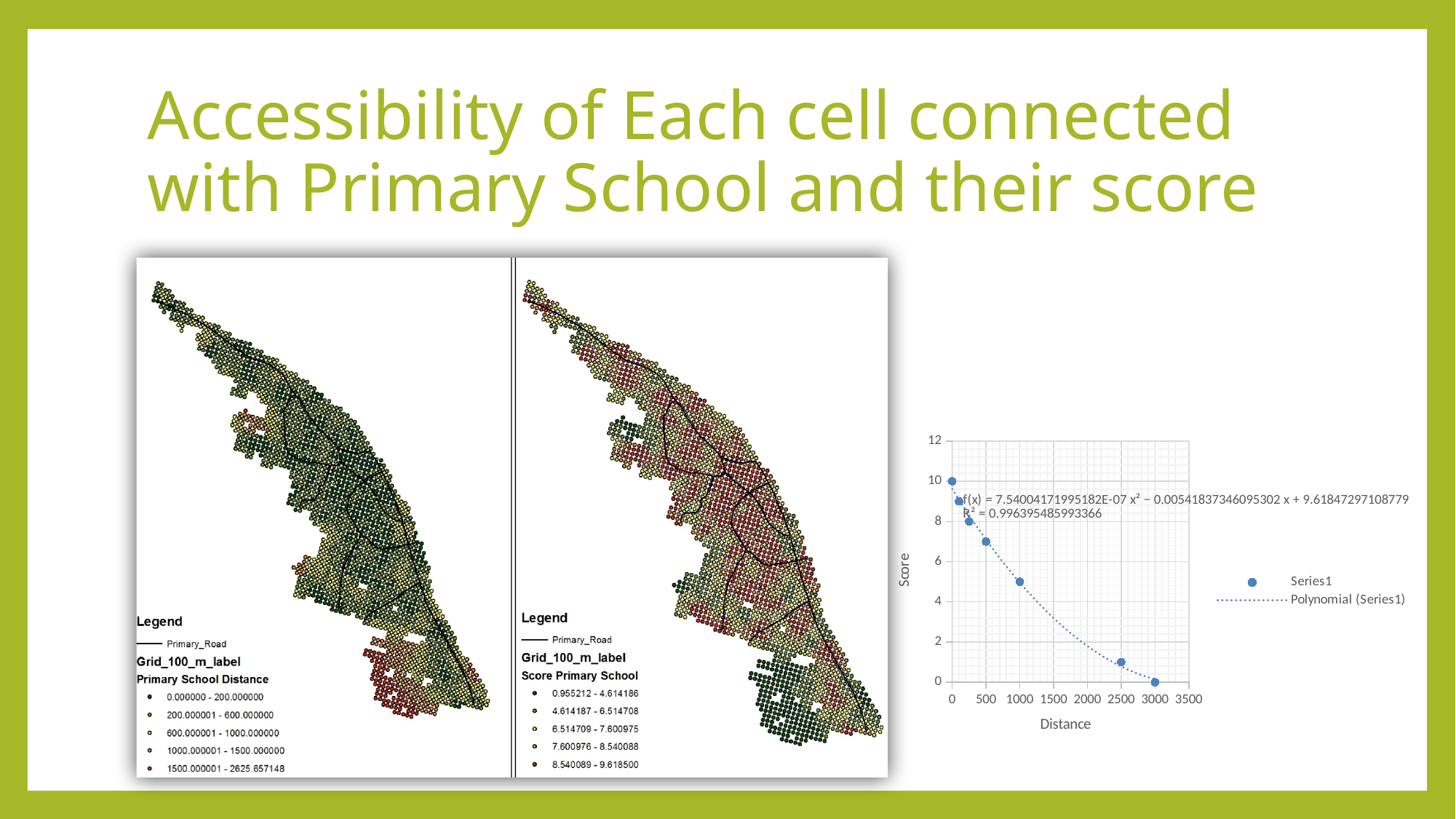
In the scatter chart, is the Score at Distance 500 greater or less than 6? greater In the scatter chart, what is the Score at Distance 0? 10 In the scatter chart, which has the larger Score: Distance 1000 or Distance 2500? Distance 1000 What kind of chart is shown on the right side of the slide? scatter chart In the scatter chart, at which Distance is the Score highest? 0 In the scatter chart, what is the Score at Distance 3000? 0 How many entries does the legend of the scatter chart list? 2 In the scatter chart, is the Score at Distance 1000 greater or less than 4? greater In the scatter chart, at which Distance is the Score lowest? 3000 What is the R² value printed on the scatter chart? 0.996395485993366 In the scatter chart, is the Score at Distance 2500 greater or less than 2? less In the scatter chart, does the Score rise or fall as Distance increases? fall